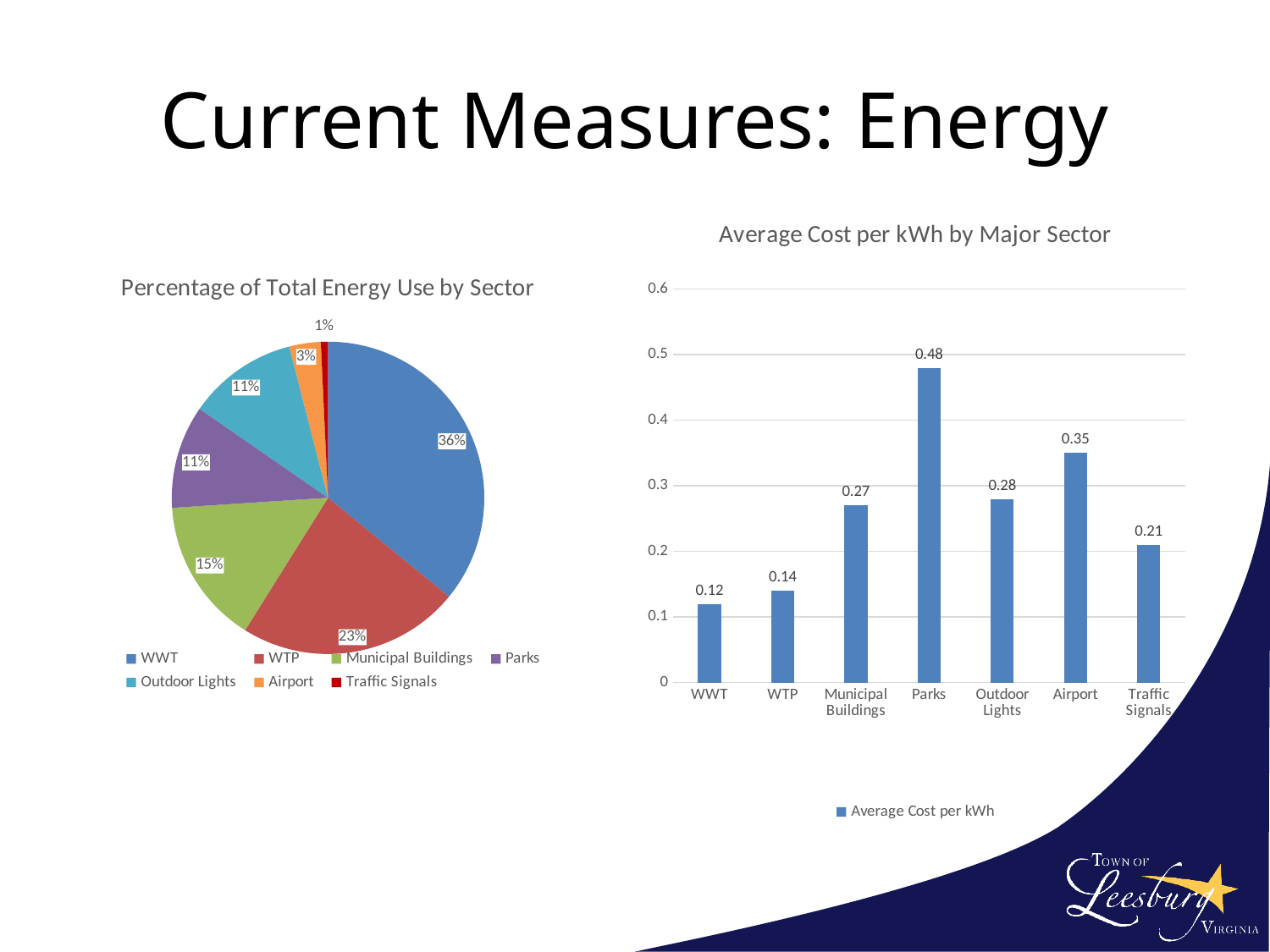
In the 'Average Cost per kWh by Major Sector' chart, what is the value for Airport? 0.35 In the 'Average Cost per kWh by Major Sector' chart, what is the value for Parks? 0.48 What kind of chart is 'Average Cost per kWh by Major Sector'? Bar chart How many series does the legend of the 'Average Cost per kWh by Major Sector' chart list? 1 In the 'Percentage of Total Energy Use by Sector' pie chart, which sector has the smallest share? Traffic Signals How many sectors are shown in the 'Average Cost per kWh by Major Sector' chart? 7 In the 'Percentage of Total Energy Use by Sector' pie chart, what share does Municipal Buildings have? 15% In the 'Average Cost per kWh by Major Sector' chart, which is larger, the value for Outdoor Lights or the value for Traffic Signals? Outdoor Lights In the 'Average Cost per kWh by Major Sector' chart, which sector has the lowest average cost per kWh? WWT In the 'Average Cost per kWh by Major Sector' chart, what is the difference between the values for Parks and WWT? 0.36 In the 'Percentage of Total Energy Use by Sector' pie chart, what share does WWT have? 36% In the 'Average Cost per kWh by Major Sector' chart, which sector has the highest average cost per kWh? Parks